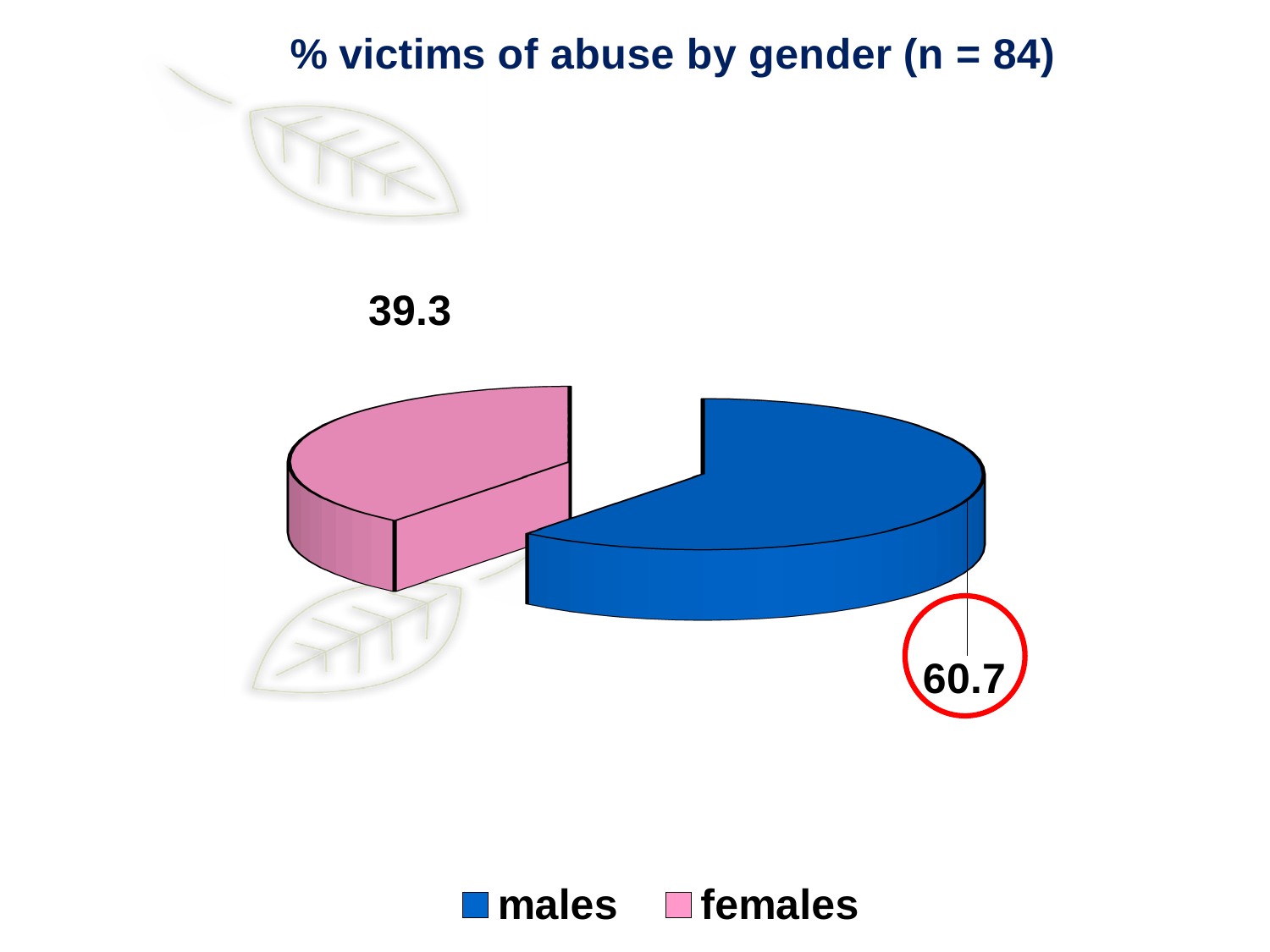
What colour is the slice for females? pink What is the title of the chart? % victims of abuse by gender (n = 84) What is the sample size (n) given in the chart title? 84 What is the difference between the values for males and females? 21.4 How many slices does the pie chart have? 2 Which gender has the smallest slice? females What is the value for females? 39.3 Which is larger, the value for males or for females? males What kind of chart is shown on the slide? pie chart Which gender has the largest slice? males How many entries does the legend list? 2 What is the value for males? 60.7